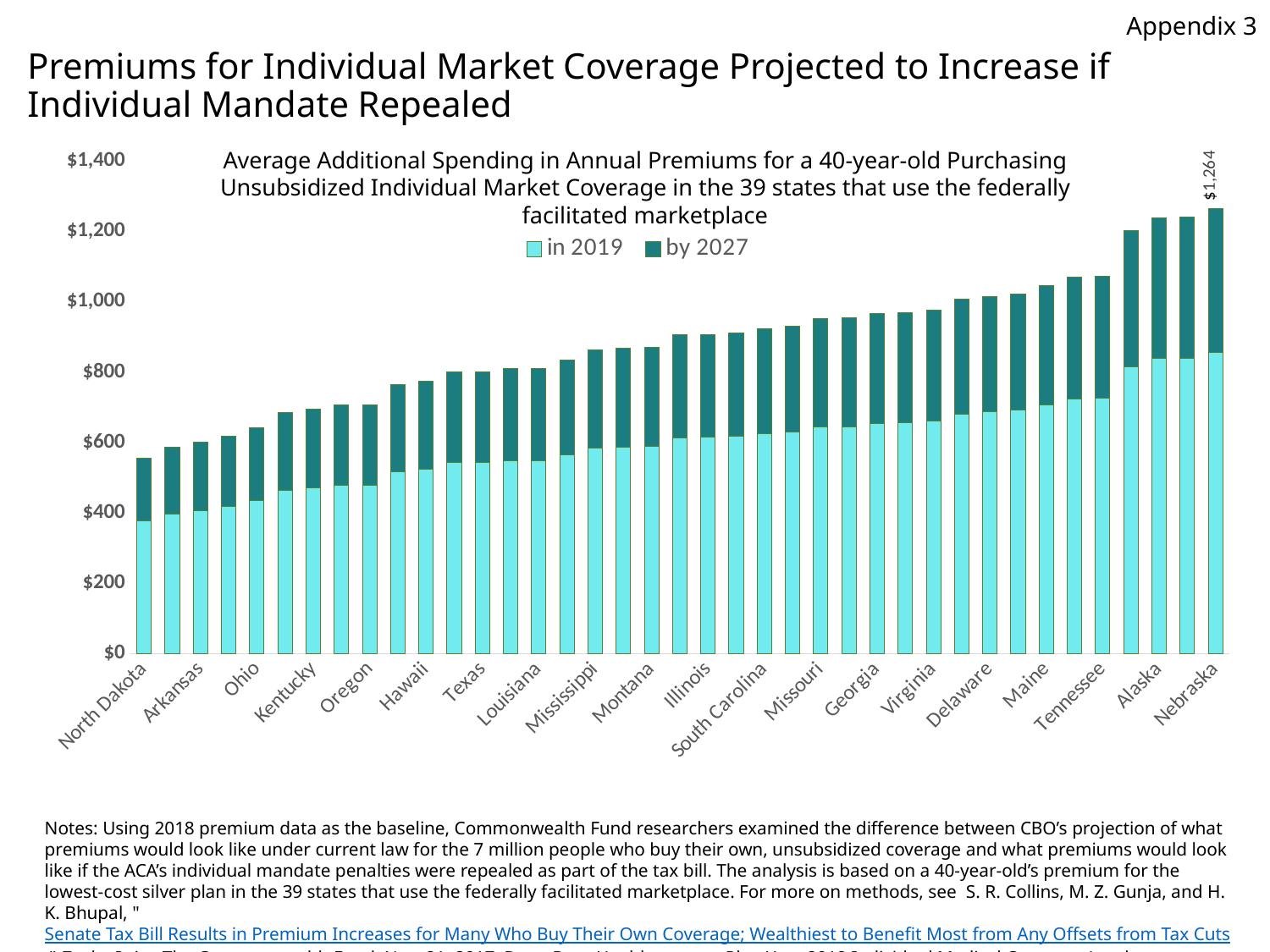
Which state has the shortest stacked bar in the chart? North Dakota Do the stacked bar totals rise or fall moving from left to right along the x axis? rise Which state has the tallest stacked bar in the chart? Nebraska Is the total stacked value for Maine greater or less than $1,000? greater Is the total stacked value for North Dakota greater or less than $600? less What are the two series named in the chart legend? in 2019 and by 2027 How many states (bars) are plotted in the chart? 39 Is the total stacked value for Hawaii greater or less than $800? less How many series does the chart legend list? 2 What kind of chart is shown on the slide? bar chart Which state has a larger total stacked bar, Alaska or Texas? Alaska What data label is printed above the Nebraska bar? $1,264